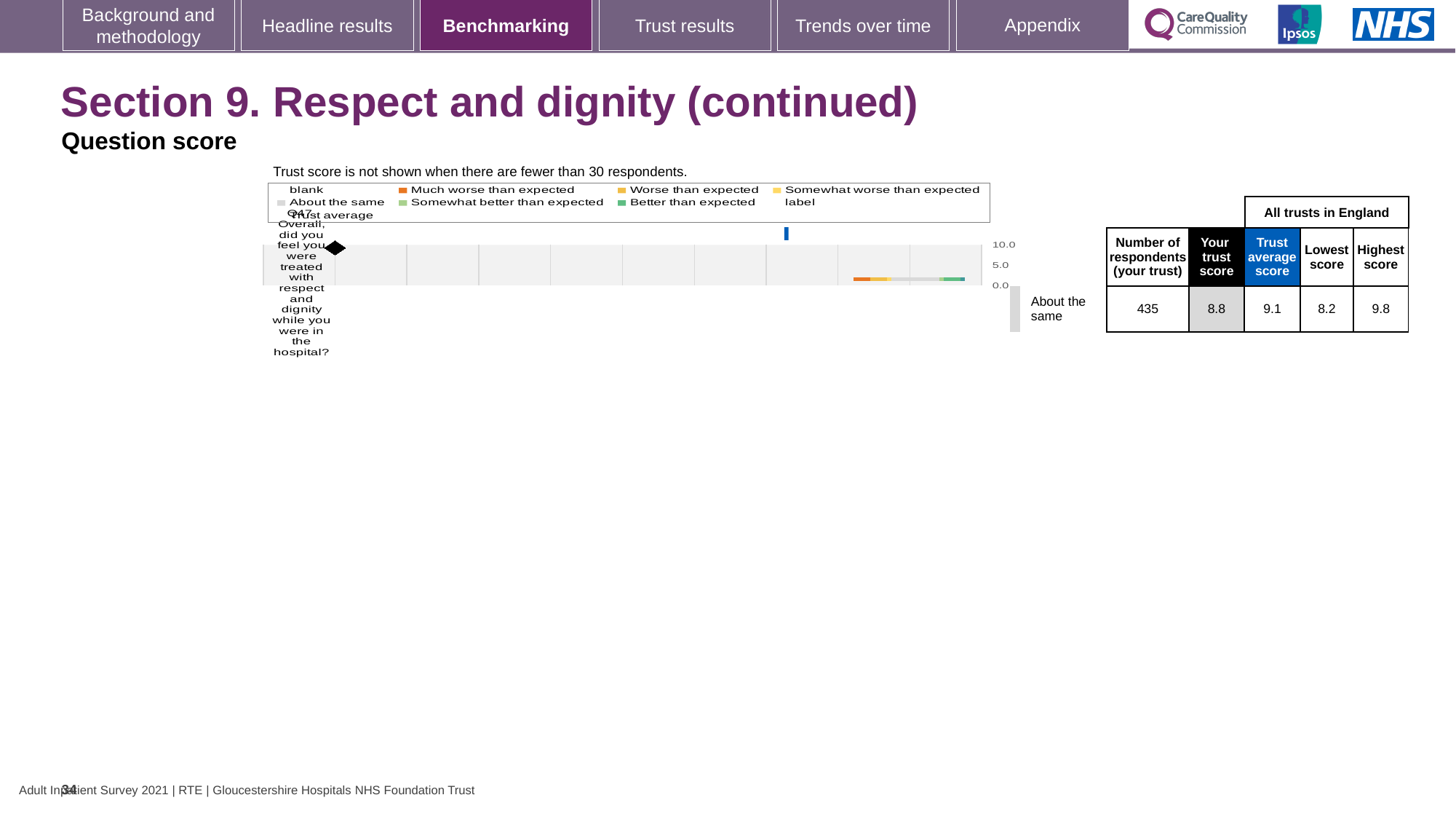
Which colour does the legend use for 'Much worse than expected'? orange According to the table, what is the trust average score for Q47? 9.1 According to the table, how many respondents from the trust answered Q47? 435 Is the trust average marker for Q47 greater or less than 5.0? greater According to the table, what is the highest score among all trusts in England for Q47? 9.8 What kind of chart is shown on the slide? bar chart What is the highest value shown on the chart's score axis? 10.0 According to the table, what is the trust's score for Q47? 8.8 How many questions are plotted on the chart? 1 According to the table, what is the lowest score among all trusts in England for Q47? 8.2 What benchmark category is shown for Q47? About the same What is the difference between the highest score and the lowest score for Q47 in the table? 1.6